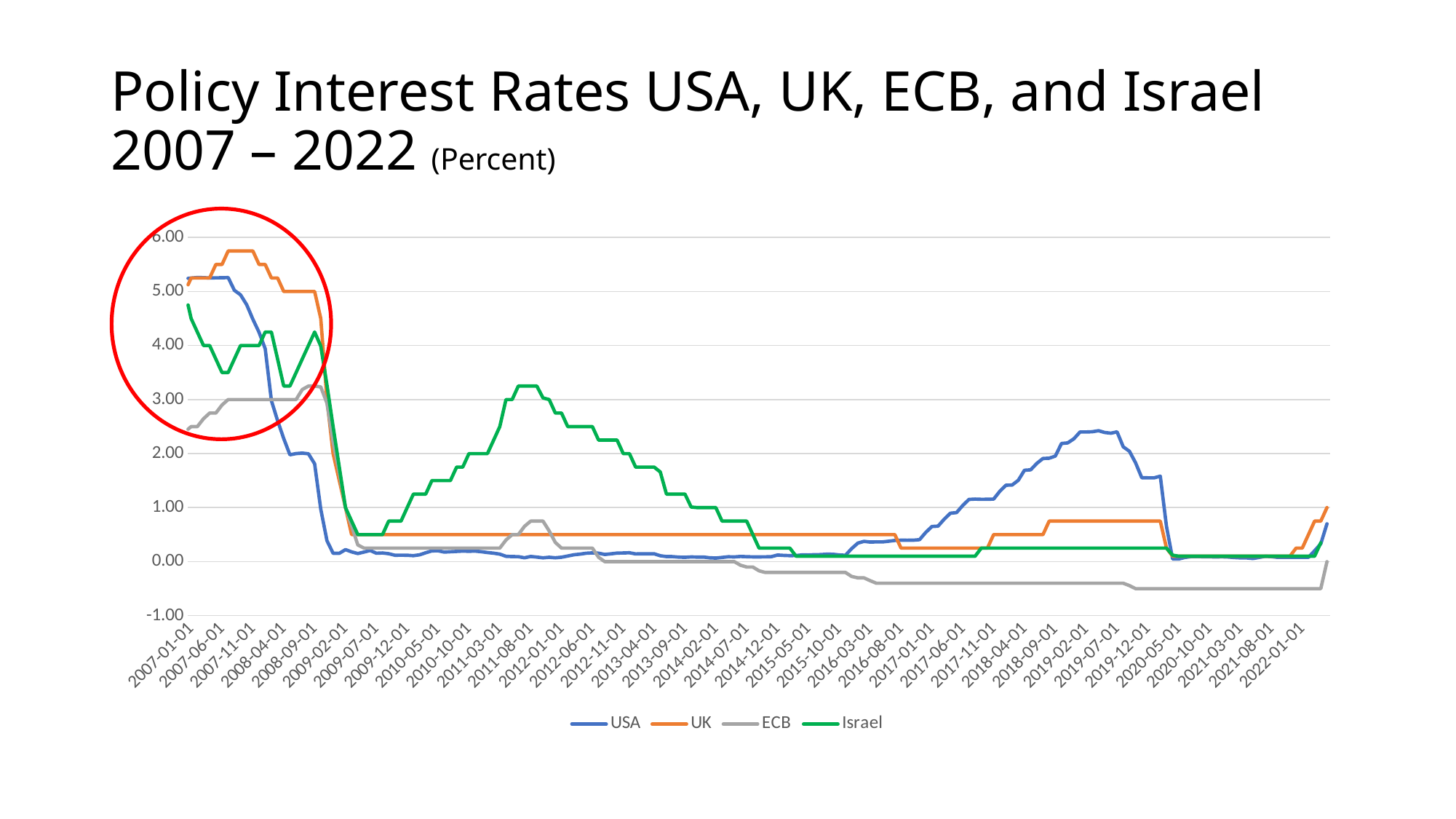
At 2012-01-01, which series is higher, Israel or USA? Israel Which series is the only one that falls below 0.00? ECB Is the Israel value at 2011-08-01 greater or less than 2.00? greater Does the Israel series rise or fall between 2011-08-01 and 2014-12-01? fall What are the series names listed in the legend? USA, UK, ECB, Israel Is the USA value at 2019-02-01 greater or less than 2.00? greater What kind of chart is shown on the slide? line chart Which series reaches the highest value anywhere on the chart? UK In what unit are the policy interest rates shown, according to the title? Percent How many series does the legend list? 4 Does the USA series rise or fall between 2016-03-01 and 2019-02-01? rise Is the UK value at 2007-11-01 greater or less than 5.00? greater